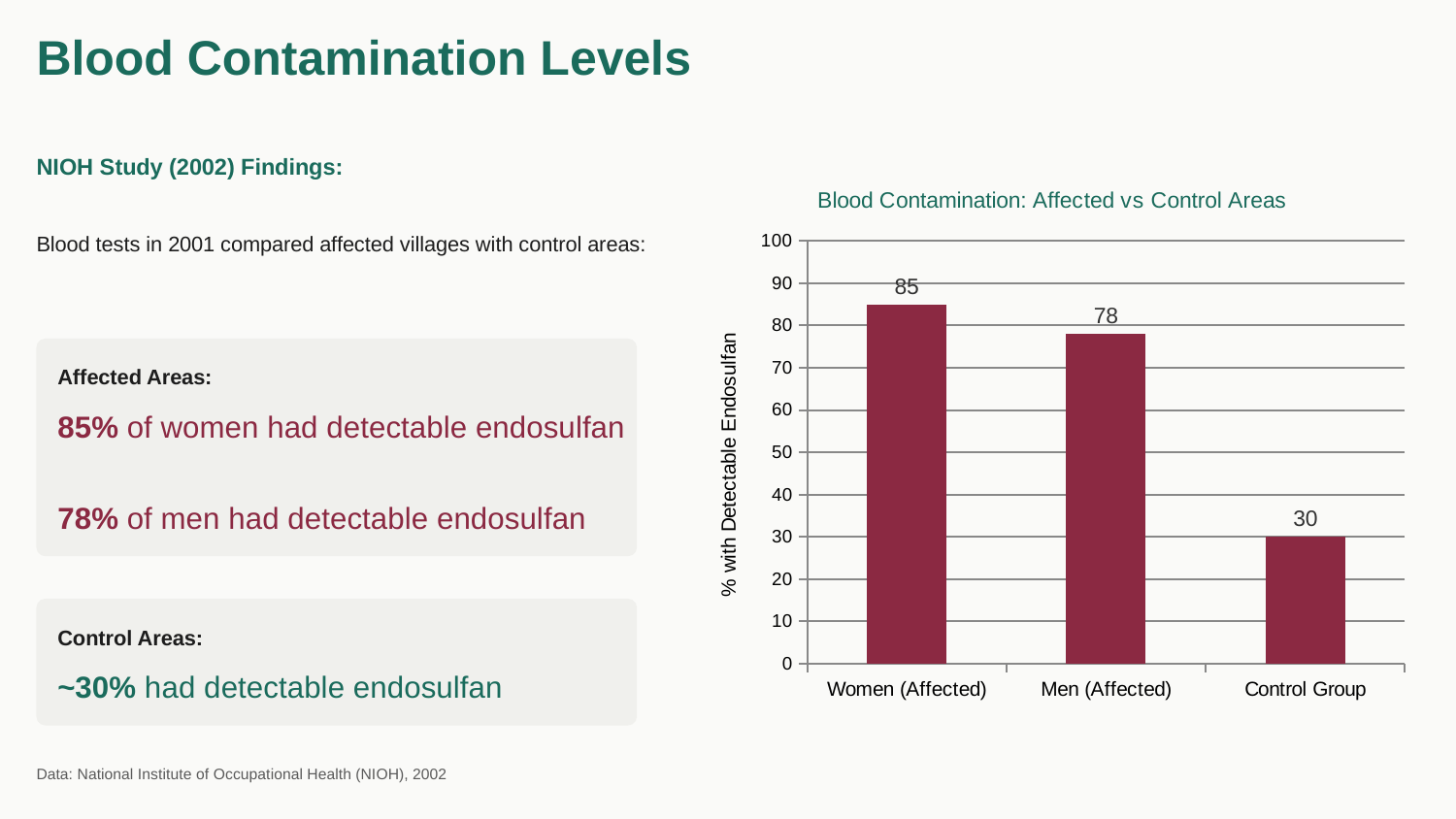
What is the value for Men (Affected)? 78 What is the difference between the values for Women (Affected) and Men (Affected)? 7 What kind of chart is shown on the slide? bar chart What is the value for Control Group? 30 Which category has the highest value? Women (Affected) What is the difference between the values for Men (Affected) and Control Group? 48 Which category has the lowest value? Control Group How many categories are shown on the chart? 3 What is the value for Women (Affected)? 85 Is the value for Control Group greater or less than 40? less Which is larger, the value for Men (Affected) or the value for Control Group? Men (Affected) What is the title of the chart? Blood Contamination: Affected vs Control Areas